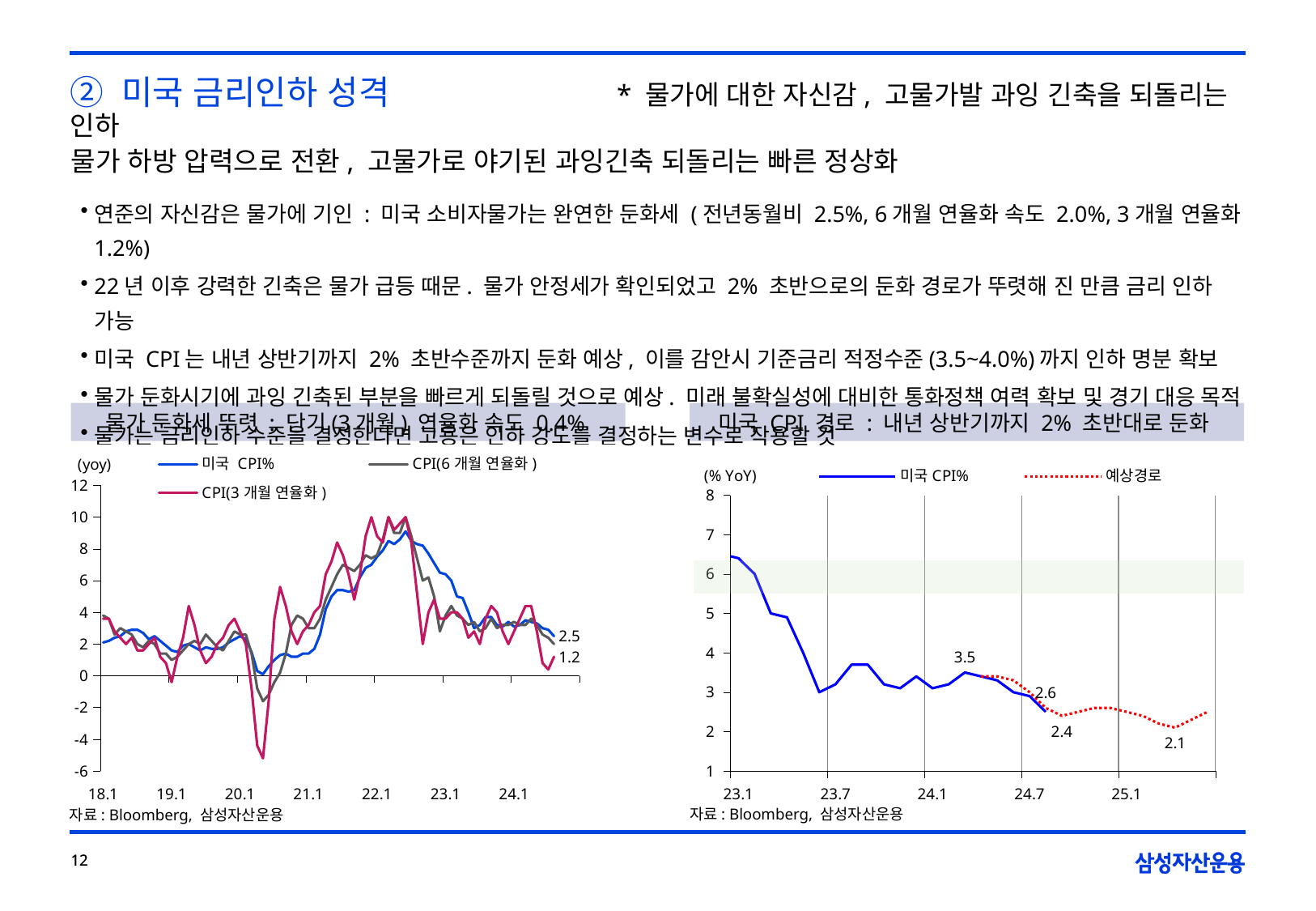
On the left chart, what is the difference between the labeled end values of 미국 CPI% (2.5) and CPI(3개월 연율화) (1.2)? 1.3 On the left chart, what is the labeled end value of the CPI(3개월 연율화) line? 1.2 On the left chart, what is the labeled end value of the 미국 CPI% line? 2.5 How many series does the legend of the left chart list? 3 On the right chart, is the value of 미국 CPI% at 23.1 greater or less than 6? greater What is the y-axis unit label shown on the right chart? (% YoY) How many series does the legend of the right chart list? 2 On the left chart, is the lowest value of the CPI(3개월 연율화) line greater or less than -4? less On the right chart, what is the difference between the labeled values 3.5 and 2.6 on the 미국 CPI% line? 0.9 What kind of chart is the left chart on the slide? line chart On the right chart, does the 미국 CPI% line generally rise or fall from 23.1 to 24.7? fall On the right chart, what is the lowest labeled value on the 예상경로 (forecast) line? 2.1